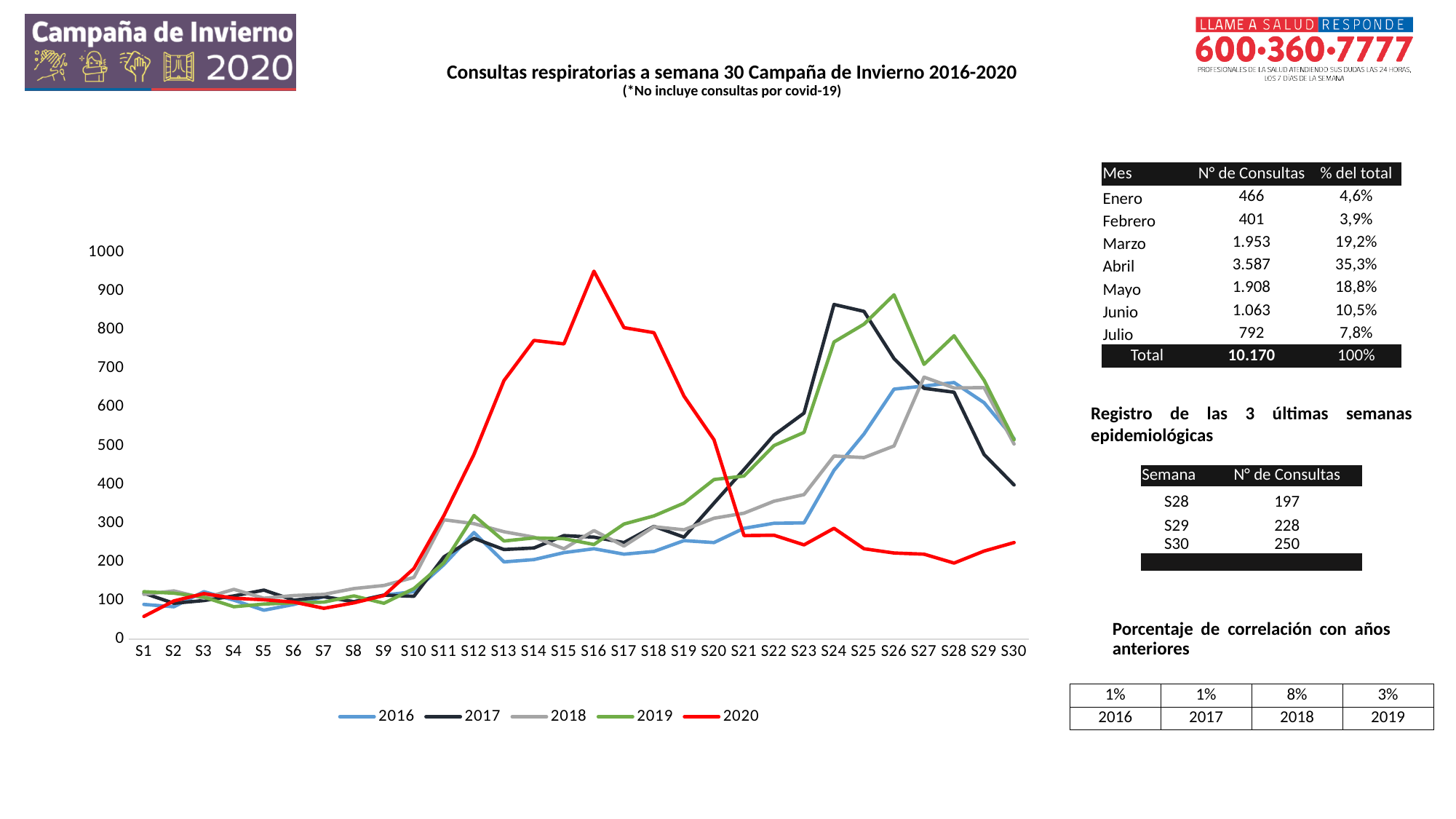
Is the value for 2017 at S30 greater or less than 500? less At S16, which series has the larger value, 2020 or 2019? 2020 At S24, which series has the larger value, 2017 or 2016? 2017 What colour is the 2020 line in the chart? red How many weeks (points) are shown along the x axis of the chart? 30 Is the value for 2019 at S26 greater or less than 800? greater How many series does the chart legend list? 5 Does the 2020 line rise or fall between S16 and S21? fall Which series reaches the highest peak on the chart? 2020 What kind of chart is shown on the slide? line chart Is the value for 2020 at S16 greater or less than 900? greater